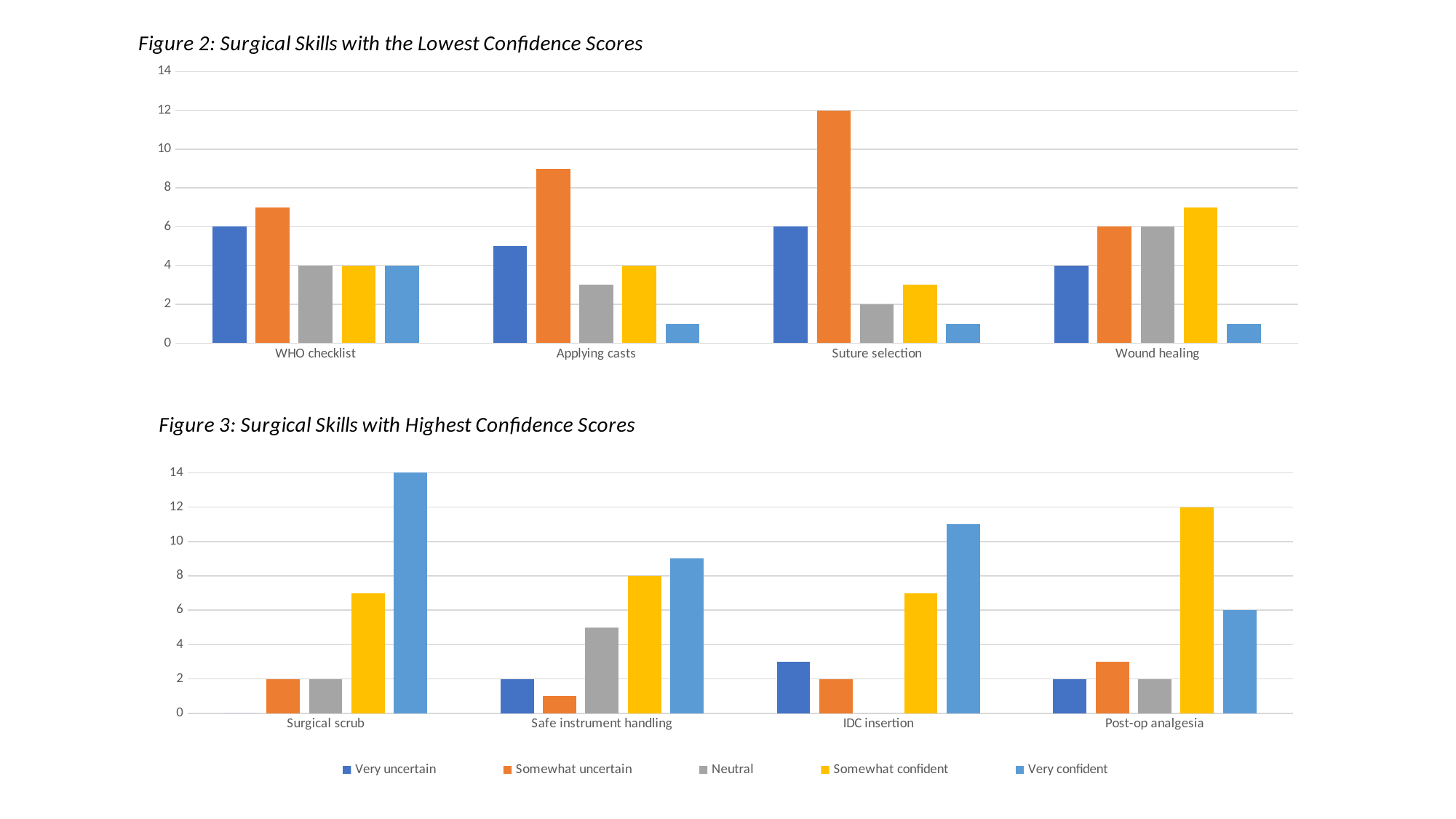
In Figure 2, what is the value of the Somewhat uncertain bar for Suture selection? 12 In Figure 2, what is the difference between the Somewhat uncertain and Very uncertain values for Suture selection? 6 In Figure 3, what is the value of the Somewhat confident bar for Post-op analgesia? 12 In Figure 2, is the Somewhat uncertain value for Applying casts greater or less than 8? greater What kind of chart is Figure 3? bar chart How many skill categories are shown in Figure 2? 4 In Figure 3, what is the value of the Very confident bar for Surgical scrub? 14 In Figure 3, which skill has the highest Very confident bar? Surgical scrub In Figure 3, is the Very confident value for IDC insertion greater or less than 10? greater In Figure 2, what is the value of the Very uncertain bar for WHO checklist? 6 How many series does the legend at the bottom of the slide list? 5 In Figure 2, which skill has the highest Somewhat uncertain bar? Suture selection